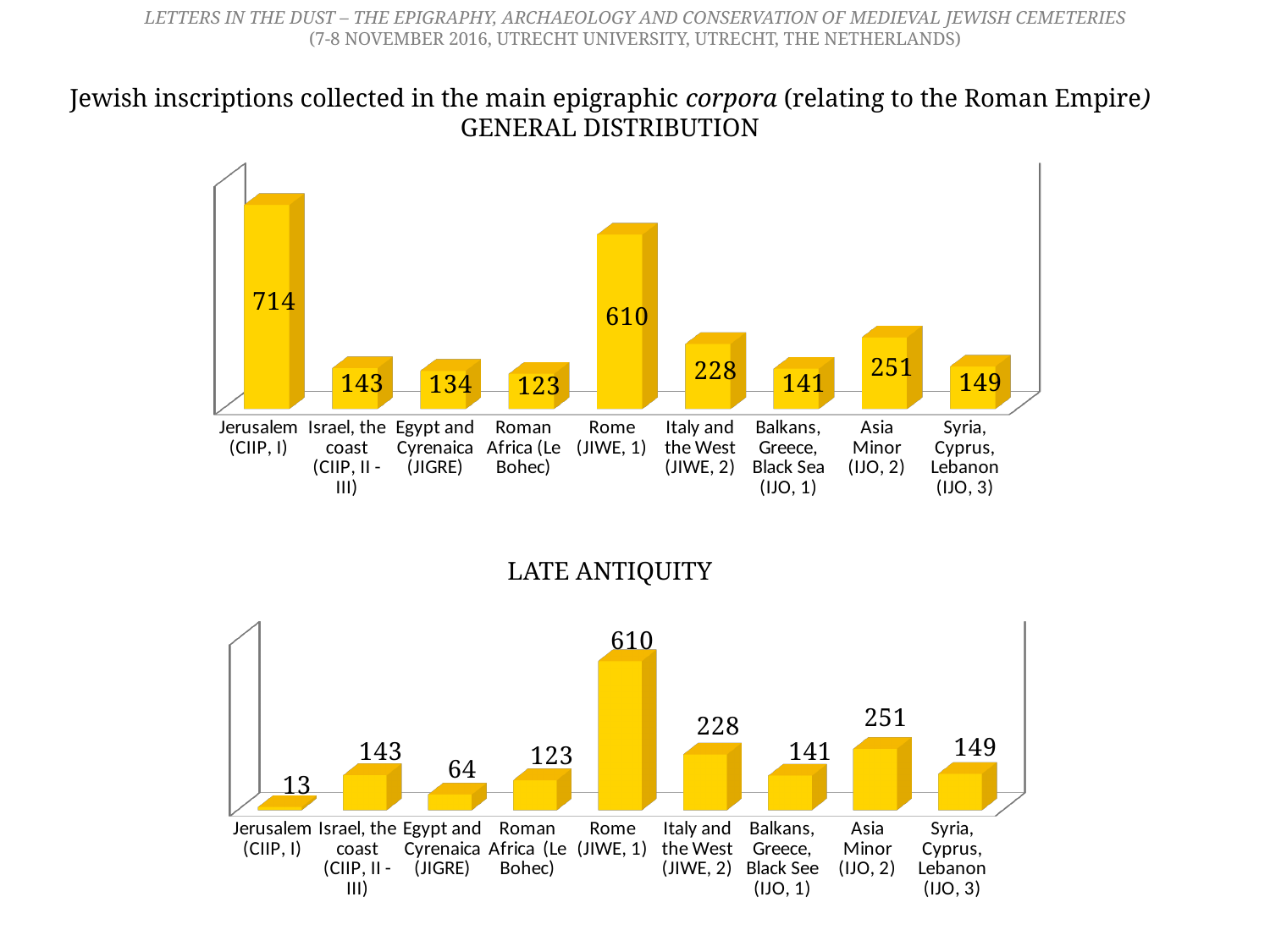
In the LATE ANTIQUITY chart, which category has the lowest value? Jerusalem (CIIP, I) In the GENERAL DISTRIBUTION chart, what is the difference between Rome (JIWE, 1) and Italy and the West (JIWE, 2)? 382 In the GENERAL DISTRIBUTION chart, which category has the highest value? Jerusalem (CIIP, I) In the LATE ANTIQUITY chart, what is the value for Jerusalem (CIIP, I)? 13 In the GENERAL DISTRIBUTION chart, what is the value for Jerusalem (CIIP, I)? 714 What type of chart is the LATE ANTIQUITY chart? Bar chart In the LATE ANTIQUITY chart, which category has the highest value? Rome (JIWE, 1) In the GENERAL DISTRIBUTION chart, which category has the lowest value? Roman Africa (Le Bohec) How many categories are shown in the GENERAL DISTRIBUTION chart? 9 In the LATE ANTIQUITY chart, what is the value for Egypt and Cyrenaica (JIGRE)? 64 What is the difference between the Jerusalem (CIIP, I) values in the GENERAL DISTRIBUTION chart and the LATE ANTIQUITY chart? 701 In the LATE ANTIQUITY chart, which is larger: Asia Minor (IJO, 2) or Italy and the West (JIWE, 2)? Asia Minor (IJO, 2)